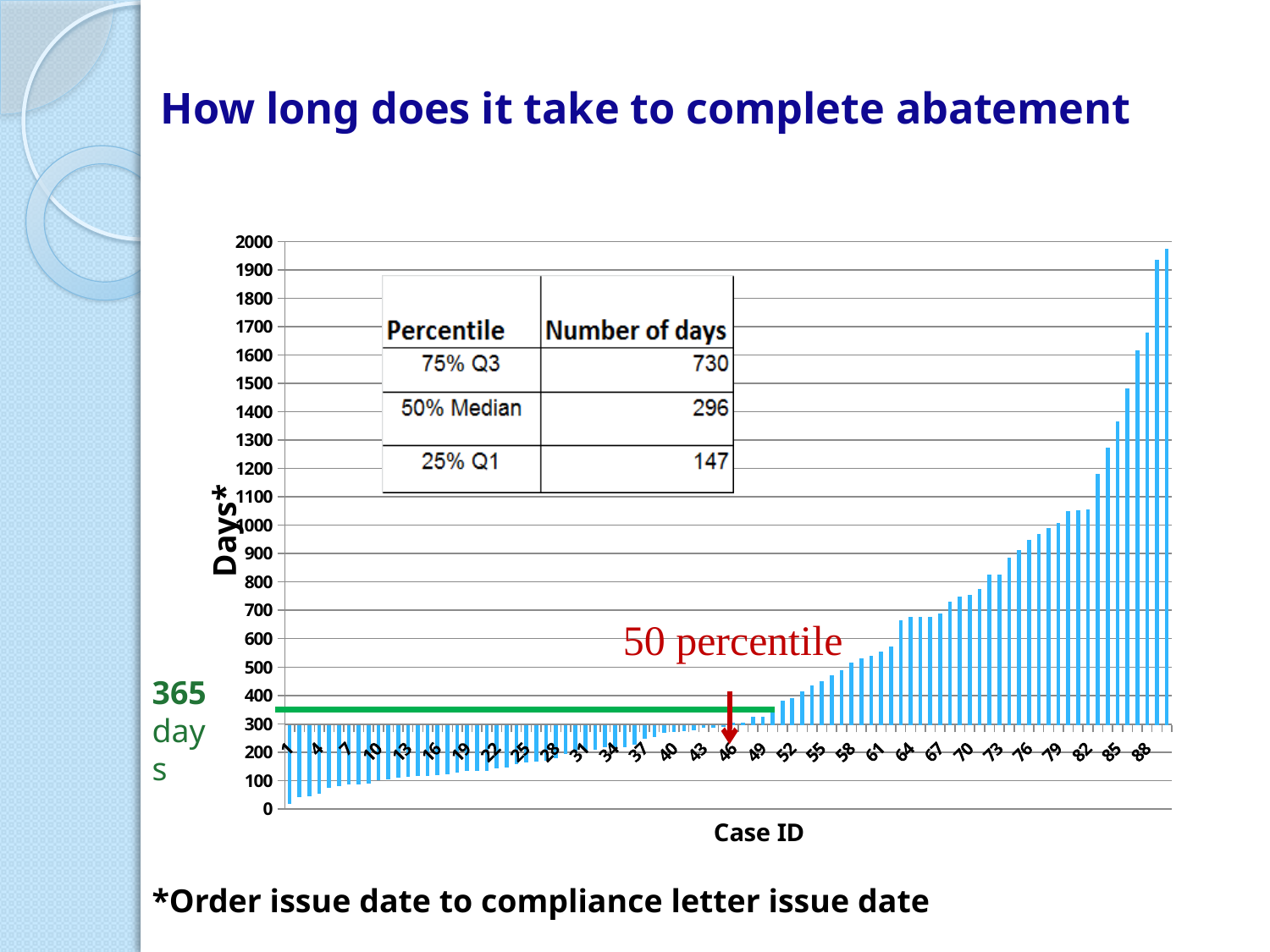
According to the table on the chart, how many days correspond to the 75% Q3 percentile? 730 Is the value for Case ID 88 greater or less than 1000 days? greater What kind of chart is shown on the slide? bar chart What is the difference in days between the 50% Median and the 25% Q1 percentile shown in the table? 149 Is the value for Case ID 1 greater or less than 100 days? less According to the table on the chart, how many days correspond to the 25% Q1 percentile? 147 Do the bar values rise or fall as Case ID increases along the x axis? rise What is the difference in days between the 75% Q3 and 25% Q1 percentiles shown in the table? 583 According to the table on the chart, how many days correspond to the 50% Median? 296 Which is larger: the 50% Median number of days or the 365-day line marked on the chart? 365 days At which Case ID does the red arrow labelled '50 percentile' point? 46 What is the label on the x axis of the chart? Case ID